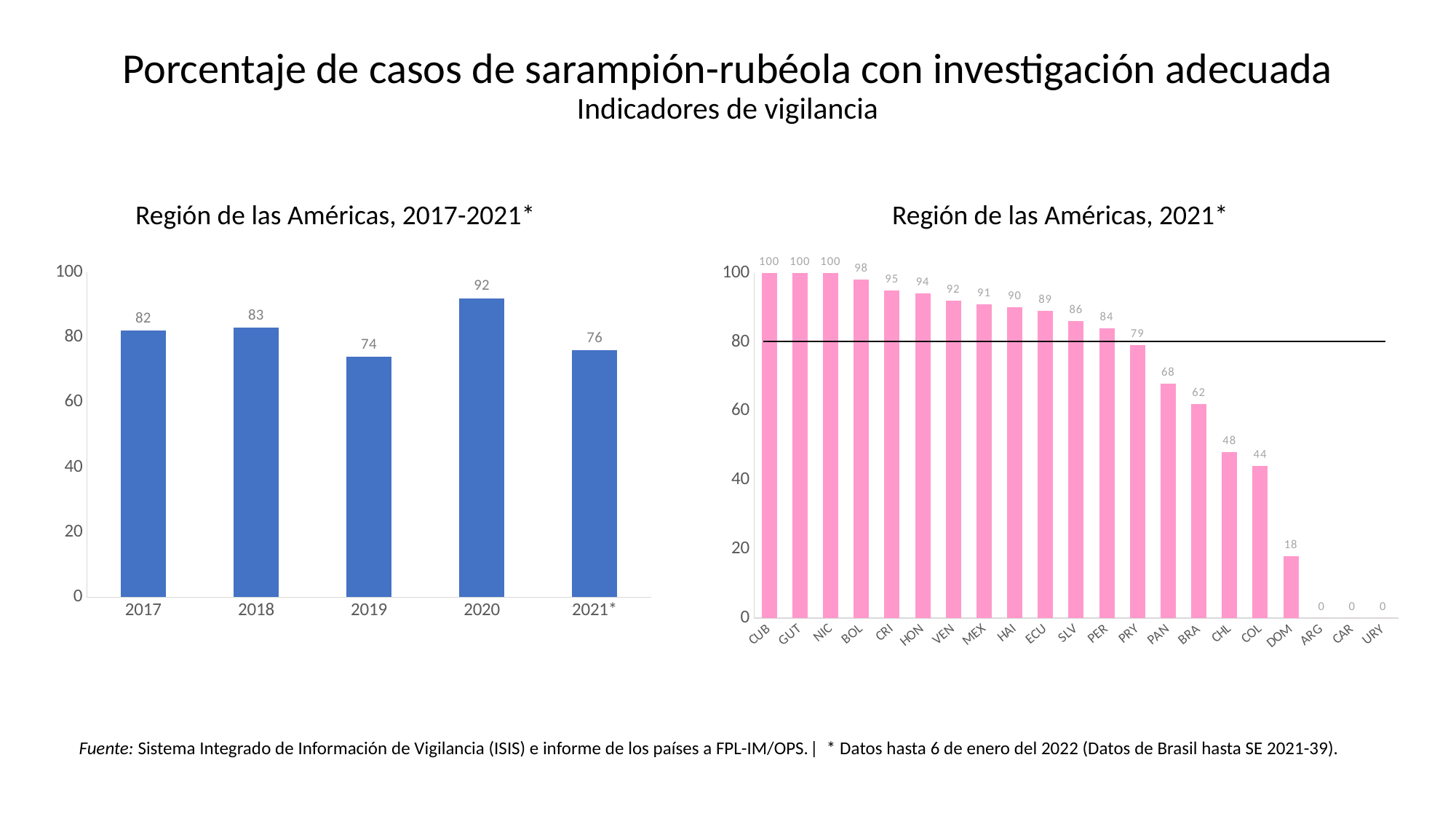
In the chart 'Región de las Américas, 2021*', which is larger, the value for PAN or the value for BRA? PAN In the chart 'Región de las Américas, 2017-2021*', which year has the lowest value? 2019 In the chart 'Región de las Américas, 2017-2021*', what is the difference between the values for 2020 and 2021*? 16 In the chart 'Región de las Américas, 2021*', what is the value for DOM? 18 In the chart 'Región de las Américas, 2017-2021*', how many years are shown on the x axis? 5 What kind of chart is 'Región de las Américas, 2021*'? bar chart In the chart 'Región de las Américas, 2017-2021*', what is the value for 2020? 92 In the chart 'Región de las Américas, 2021*', what is the value for PRY? 79 In the chart 'Región de las Américas, 2017-2021*', is the value for 2018 greater or less than 80? greater In the chart 'Región de las Américas, 2021*', do the values rise or fall from left to right along the x axis? fall In the chart 'Región de las Américas, 2021*', how many countries are shown on the x axis? 21 In the chart 'Región de las Américas, 2021*', what is the difference between the values for CHL and COL? 4